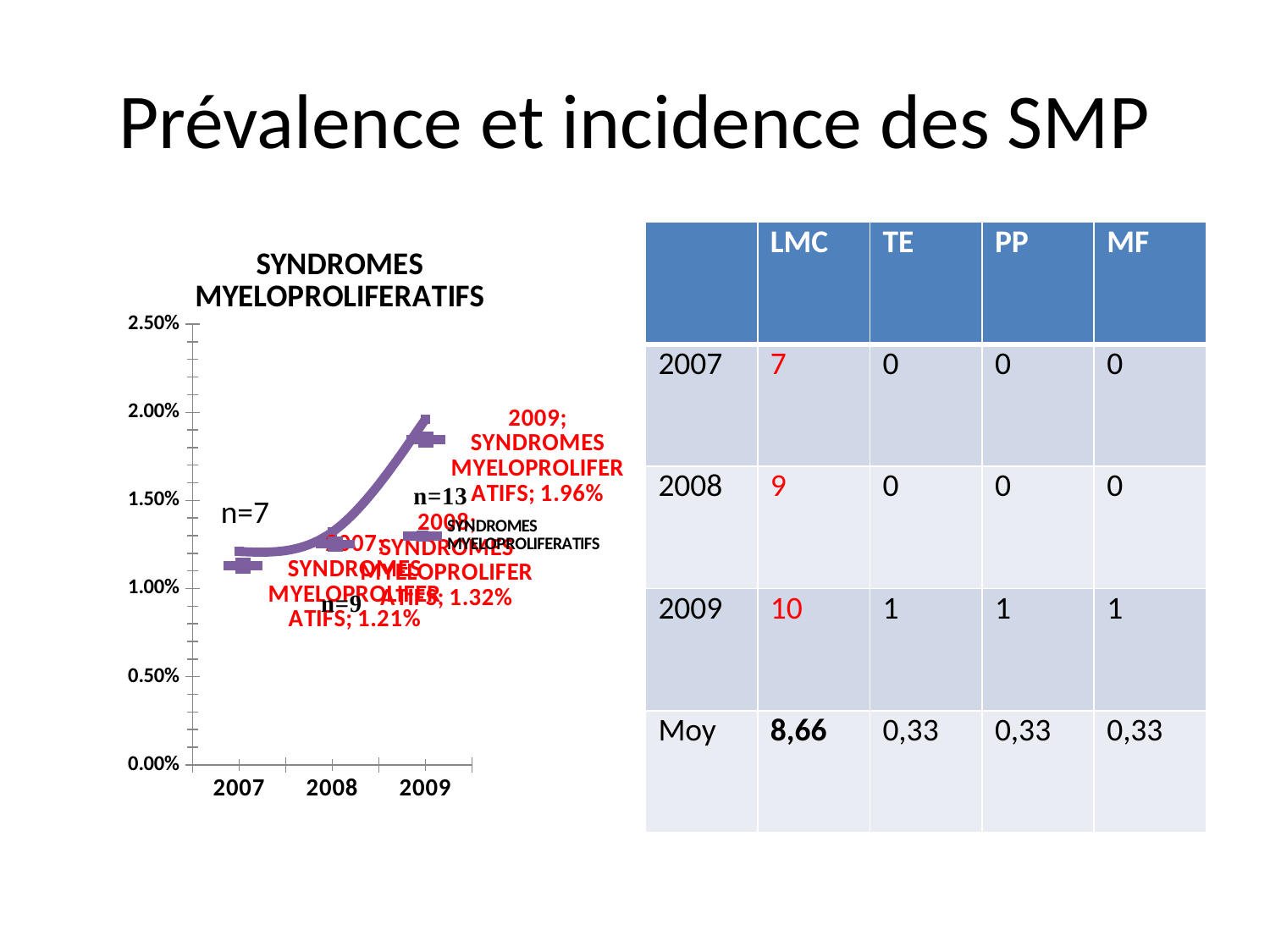
What is the difference between the 2009 and 2007 values in the chart? 0.75% What is the title of the chart? SYNDROMES MYELOPROLIFERATIFS What is the value for 2007 in the chart? 1.21% What is the value for 2009 in the chart? 1.96% How many years are plotted on the x axis of the chart? 3 What is the value for 2008 in the chart? 1.32% Which is larger in the chart, the value for 2008 or the value for 2009? 2009 Is the value for 2009 greater or less than 1.50%? greater Which year has the lowest value in the chart? 2007 Which year has the highest value in the chart? 2009 Do the values in the chart rise or fall from 2007 to 2009? rise What type of chart is shown on the slide? line chart